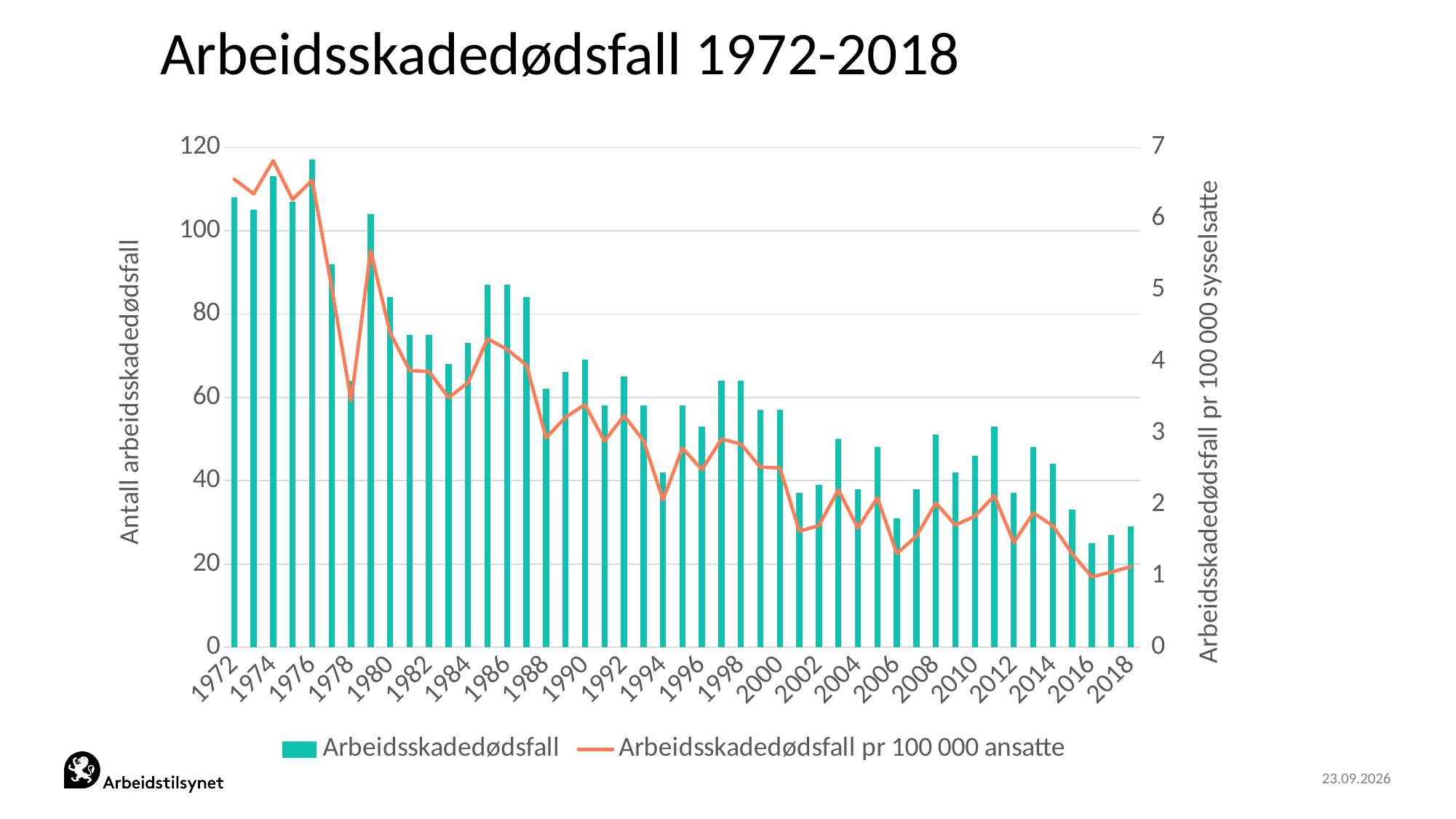
Which year has the larger bar value, 1972 or 2000? 1972 What is the label of the right-hand vertical axis? Arbeidsskadedødsfall pr 100 000 sysselsatte What is the title of the chart? Arbeidsskadedødsfall 1972-2018 Is the line value (per 100 000 ansatte) for 1974 greater or less than 6? greater Is the bar value for 1972 greater or less than 100? greater Is the bar value for 1994 greater or less than 60? less What kind of chart is shown on the slide? A combined bar and line chart Which year has the highest bar for Arbeidsskadedødsfall? 1976 How many series does the legend list? 2 Do the bar values for Arbeidsskadedødsfall generally rise or fall from 1972 to 2018? Fall How many years (bars) are plotted on the chart? 47